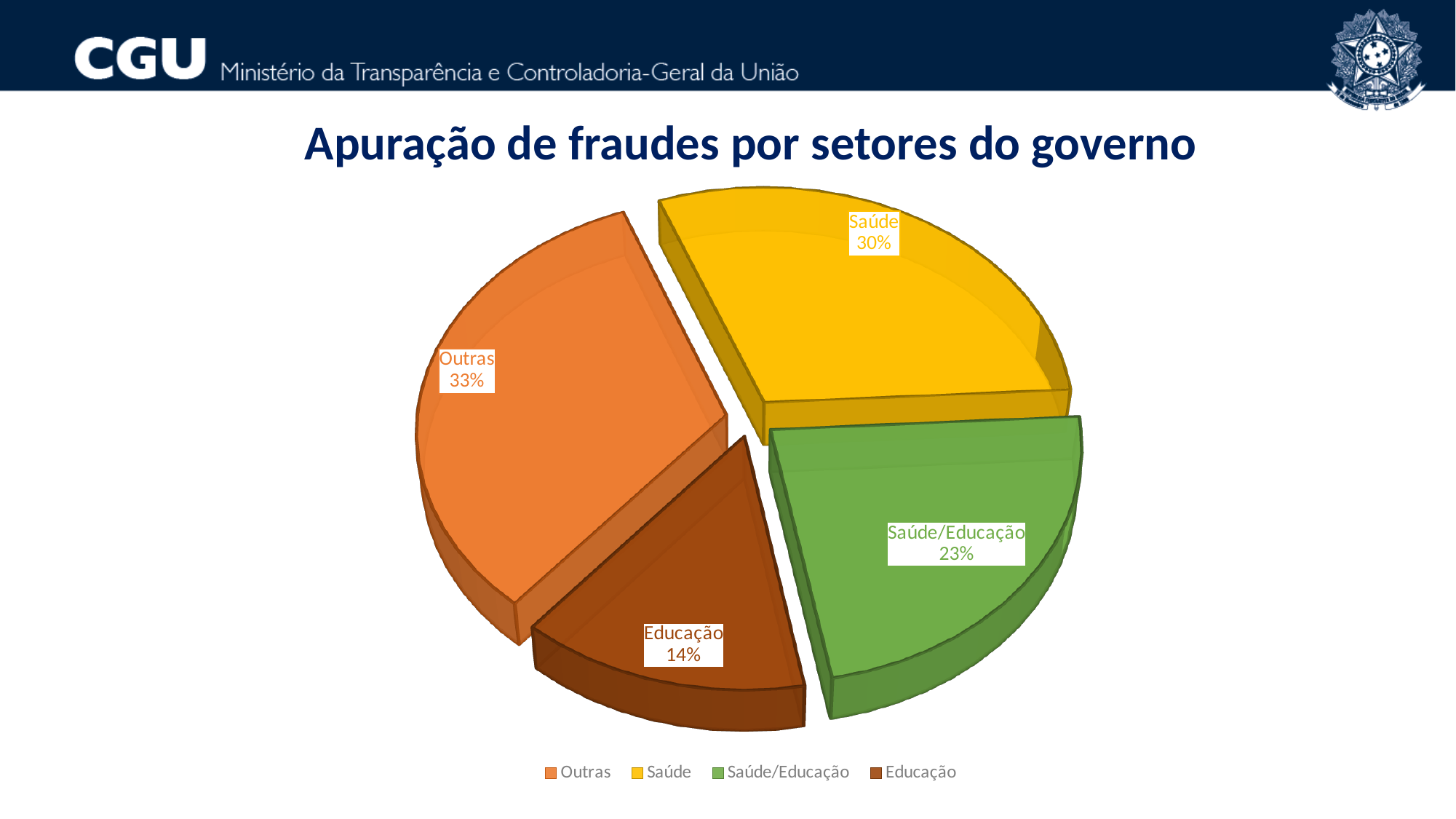
How many slices does the pie chart have? 4 What kind of chart is shown on the slide? Pie chart What share of the pie does Saúde represent? 30% What is the difference in percentage points between Saúde and Saúde/Educação? 7 Which is larger, the slice for Saúde or the slice for Saúde/Educação? Saúde Which sector has the smallest slice of the pie? Educação What share of the pie does Outras represent? 33% What share of the pie does Educação represent? 14% What is the difference in percentage points between Outras and Educação? 19 What share of the pie does Saúde/Educação represent? 23% What is the title of the chart? Apuração de fraudes por setores do governo Which sector has the largest slice of the pie? Outras